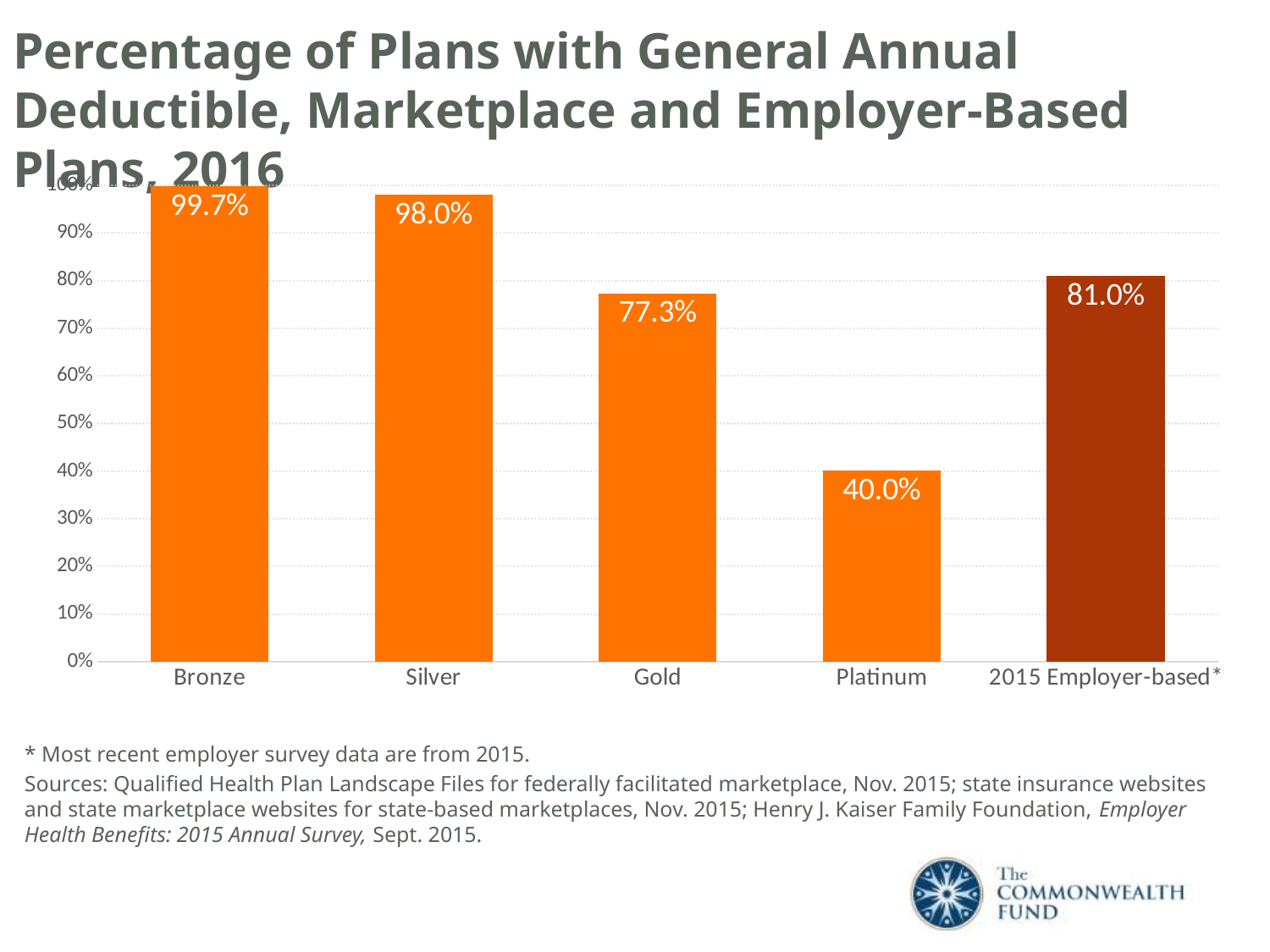
Which category has the highest value? Bronze Which category has the lowest value? Platinum Which bar is shown in a darker colour than the others? 2015 Employer-based How many categories are shown on the x axis? 5 What is the value for Gold plans? 77.3% What is the value for Platinum plans? 40.0% What is the value for Silver plans? 98.0% What kind of chart is shown on the slide? Bar chart Which is larger, the value for Gold or the value for 2015 Employer-based? 2015 Employer-based What is the value for 2015 Employer-based plans? 81.0% What is the value for Bronze plans? 99.7% What is the difference between the Gold and Platinum values? 37.3 percentage points